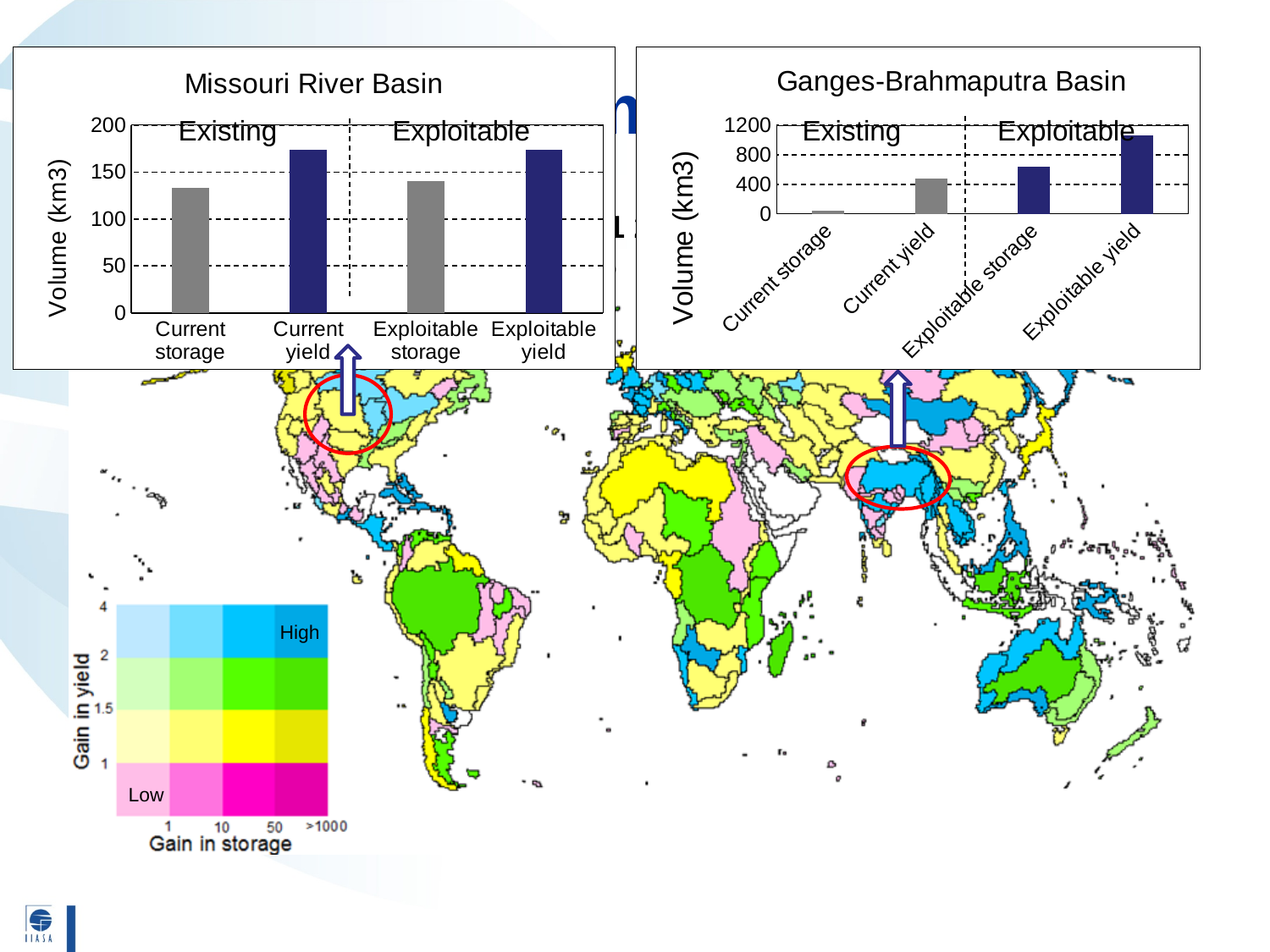
In the Missouri River Basin chart, is the value for Current yield greater or less than 150? greater What is the y-axis title of the Missouri River Basin chart? Volume (km3) In the Ganges-Brahmaputra Basin chart, which category has the highest value? Exploitable yield In the Missouri River Basin chart, is the value for Exploitable storage greater or less than 150? less In the Ganges-Brahmaputra Basin chart, which is larger, Current yield or Exploitable yield? Exploitable yield In the Missouri River Basin chart, is the value for Current storage greater or less than 100? greater In the Missouri River Basin chart, which is larger, Current storage or Current yield? Current yield In the Ganges-Brahmaputra Basin chart, which category has the lowest value? Current storage What kind of chart is the Missouri River Basin chart? bar chart How many categories are shown on the x axis of the Ganges-Brahmaputra Basin chart? 4